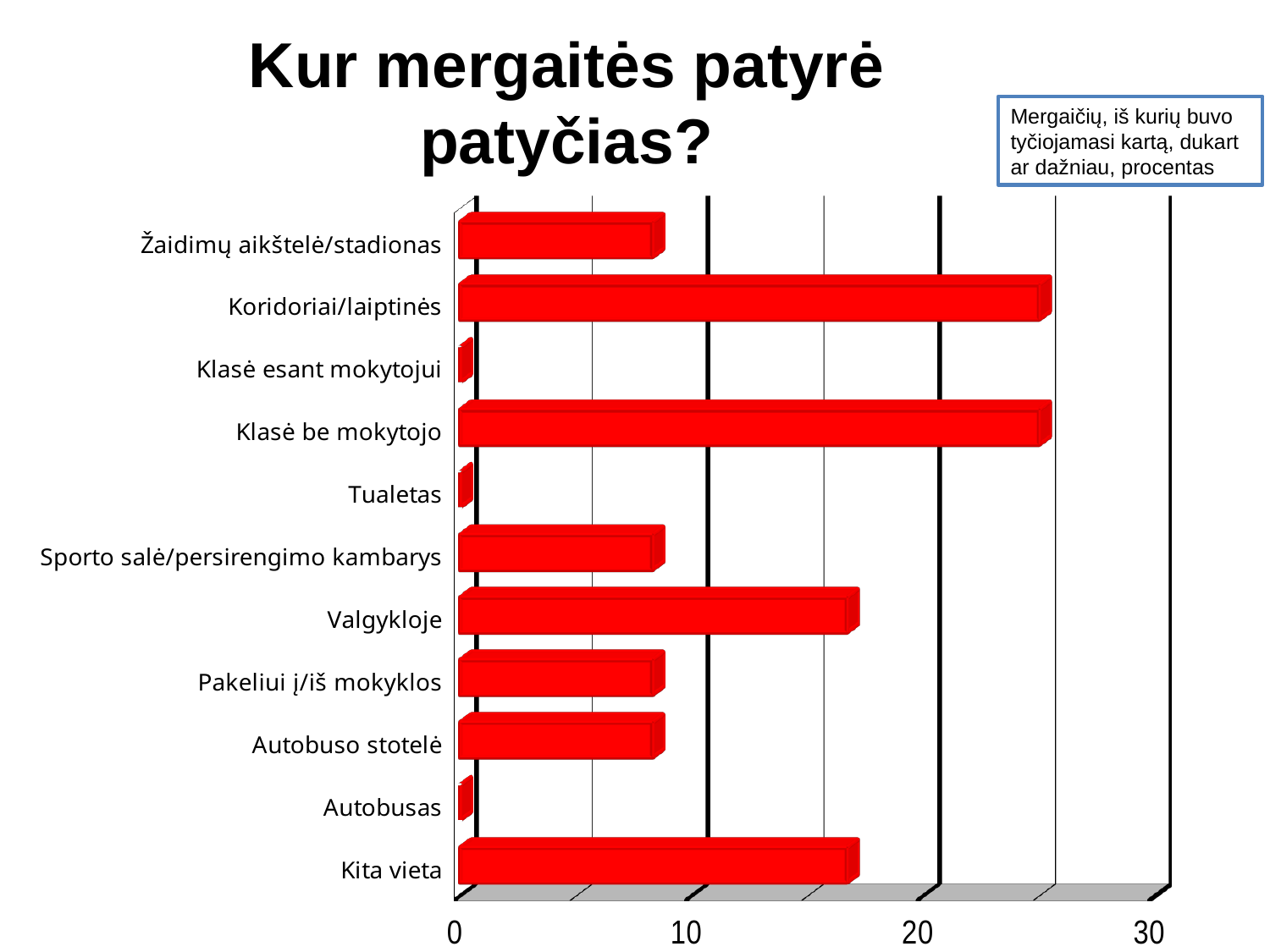
Which has the larger value, Kita vieta or Autobuso stotelė? Kita vieta Is the value for Žaidimų aikštelė/stadionas greater or less than 10? less Which has the larger value, Klasė be mokytojo or Klasė esant mokytojui? Klasė be mokytojo Is the value for Kita vieta greater or less than 10? greater Is the value for Koridoriai/laiptinės greater or less than 20? greater What is the title of the chart on the slide? Kur mergaitės patyrė patyčias? What kind of chart is shown on the slide? bar chart Which has the larger value, Koridoriai/laiptinės or Valgykloje? Koridoriai/laiptinės How many categories (locations) are plotted in the chart? 11